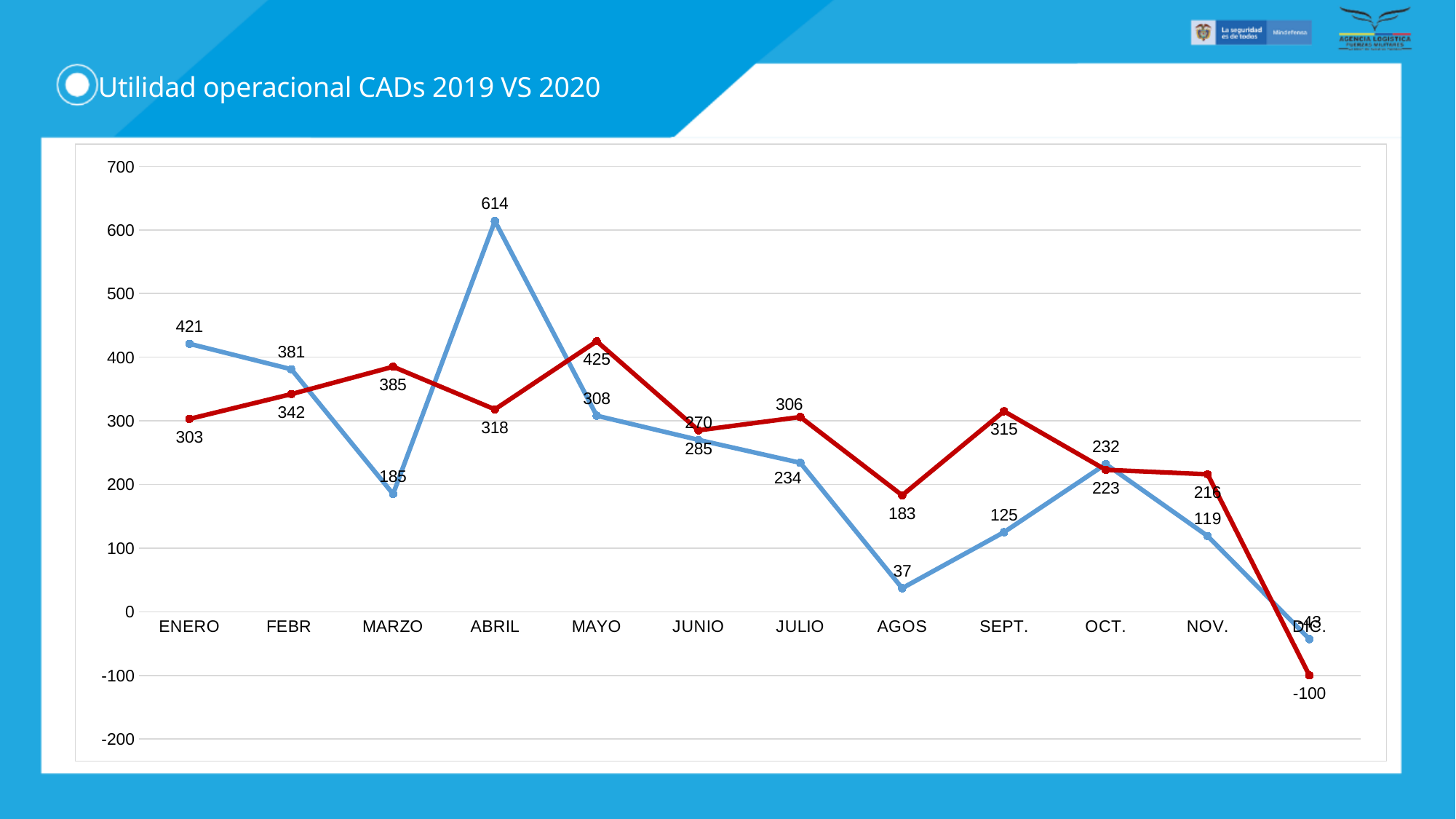
In which month does the blue line reach its highest value? ABRIL What is the value of the blue line in ABRIL? 614 What is the difference between the blue line and the red line in ENERO? 118 What is the difference between the red line's value in MAYO and its value in AGOS? 242 What is the value of the red line in AGOS? 183 What is the value of the blue line in SEPT.? 125 In which month does the red line reach its lowest value? DIC. What type of chart is shown on the slide? line chart In MARZO, which line has the higher value, the blue line or the red line? red line How many months are shown on the x axis? 12 What is the value of the red line in MAYO? 425 Does the red line rise or fall from OCT. to DIC.? fall